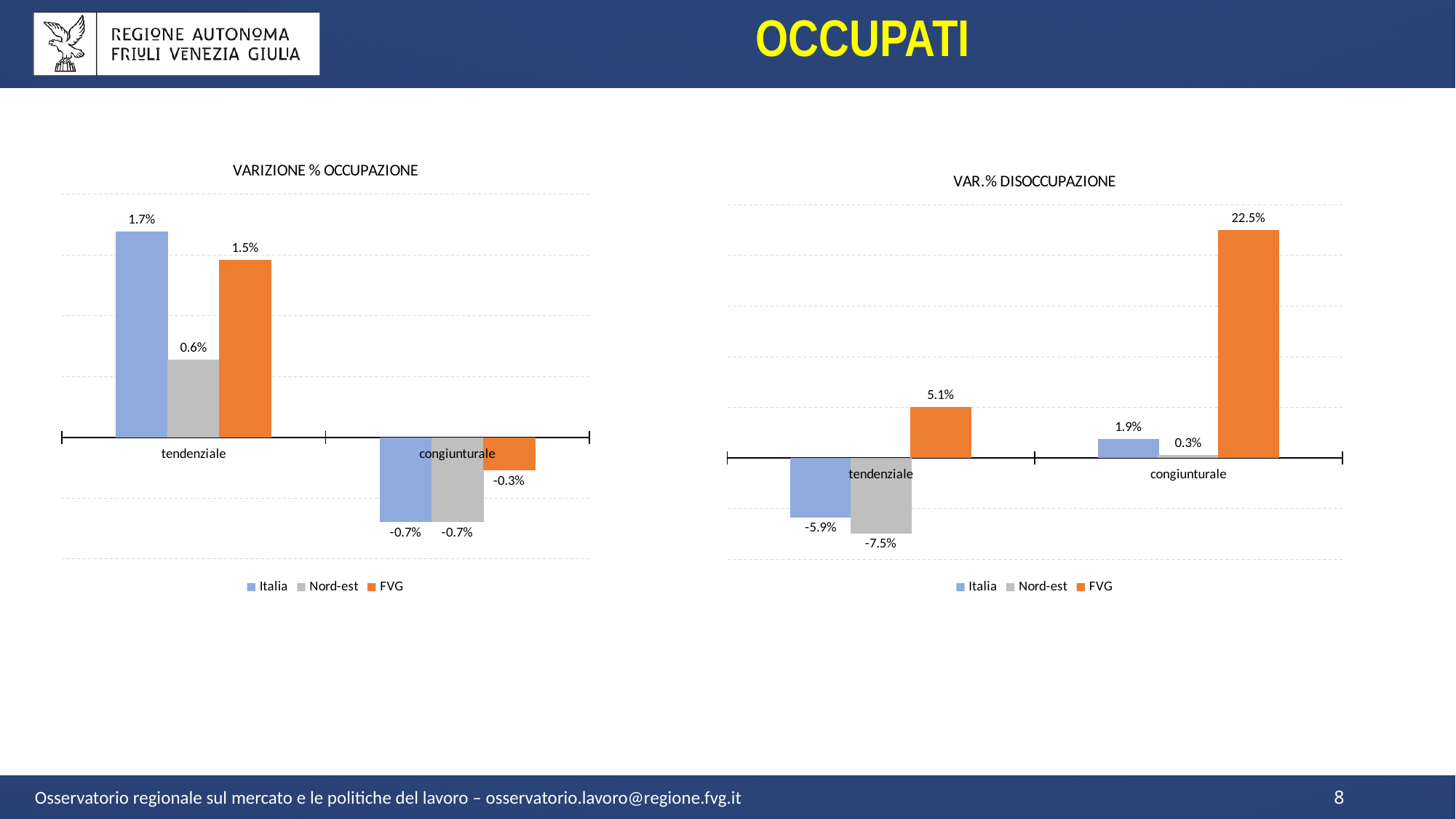
In the VARIZIONE % OCCUPAZIONE chart, which series has the lowest value in the tendenziale category? Nord-est In the VAR.% DISOCCUPAZIONE chart, what is the value for FVG in the congiunturale category? 22.5% In the VAR.% DISOCCUPAZIONE chart, what is the value for Nord-est in the tendenziale category? -7.5% In the VARIZIONE % OCCUPAZIONE chart, what is the difference between the Italia and FVG values in the tendenziale category? 0.2% In the VARIZIONE % OCCUPAZIONE chart, how many series does the legend list? 3 In the VAR.% DISOCCUPAZIONE chart, what is the difference between the FVG values for congiunturale and tendenziale? 17.4% In the VAR.% DISOCCUPAZIONE chart, which is larger in the congiunturale category: Italia or Nord-est? Italia In the VARIZIONE % OCCUPAZIONE chart, what is the value for Italia in the tendenziale category? 1.7% In the VARIZIONE % OCCUPAZIONE chart, what is the value for FVG in the congiunturale category? -0.3% What kind of chart is the VAR.% DISOCCUPAZIONE chart? Bar chart In the VAR.% DISOCCUPAZIONE chart, which series has the highest value in the tendenziale category? FVG In the VARIZIONE % OCCUPAZIONE chart, how many categories are shown on the x axis? 2